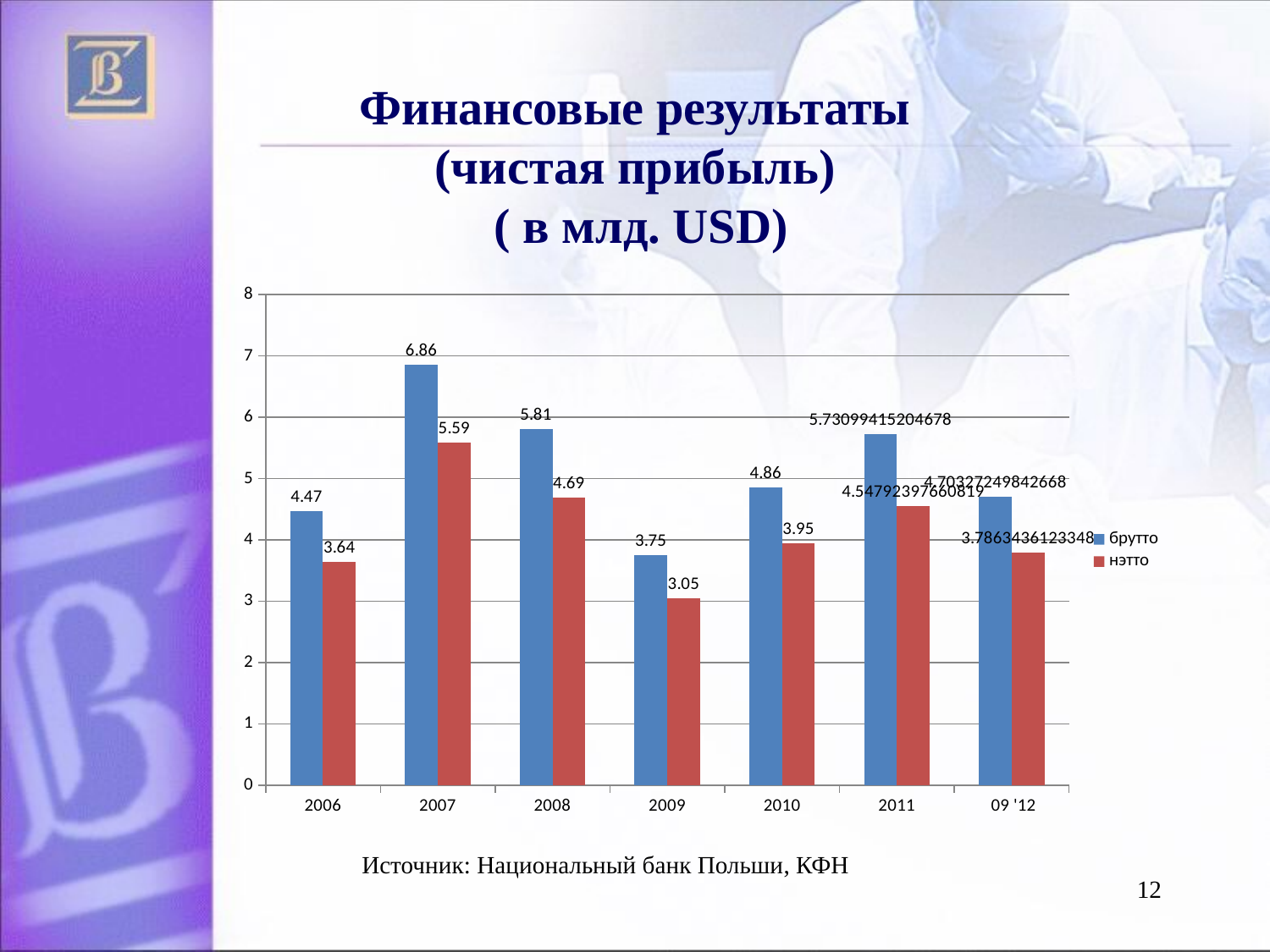
How many categories are shown on the x axis? 7 Which year has the highest брутто value? 2007 What type of chart is shown on the slide? bar chart What is the брутто value for 2007? 6.86 Is the брутто value for 2011 greater or less than 5? greater What is the нэтто value for 2009? 3.05 Which year has the lowest нэтто value? 2009 What is the difference between the брутто and нэтто values for 2008? 1.12 What is the брутто value for 2010? 4.86 Which is larger, the нэтто value for 2006 or the нэтто value for 2010? 2010 Which series is shown in blue in the legend? брутто How many series does the legend list? 2